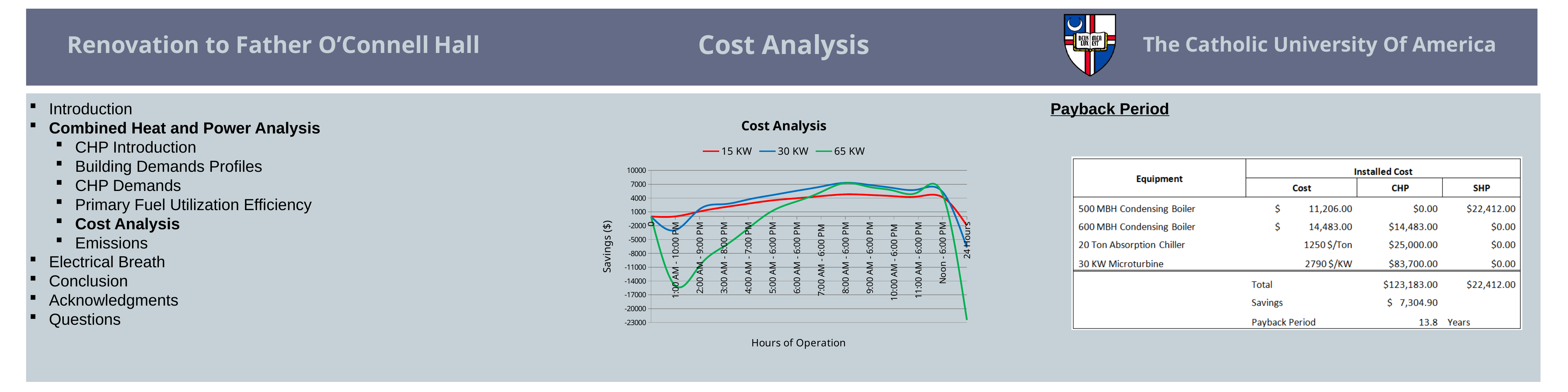
What is the label of the x axis of the Cost Analysis chart? Hours of Operation Is the value for 30 KW at 8:00 AM - 6:00 PM greater or less than 4000? greater Which series has the lowest value at 24 Hours? 65 KW How many categories are shown on the x axis of the Cost Analysis chart? 14 How many series does the legend of the Cost Analysis chart list? 3 At 1:00 AM - 10:00 PM, which series has the larger value, 15 KW or 65 KW? 15 KW Does the 65 KW series rise or fall from 1:00 AM - 10:00 PM to 8:00 AM - 6:00 PM? rise Is the value for 65 KW at 24 Hours greater or less than -17000? less What is the label of the y axis of the Cost Analysis chart? Savings ($) What kind of chart is the Cost Analysis chart? line chart Is the value for 65 KW at 1:00 AM - 10:00 PM greater or less than -8000? less